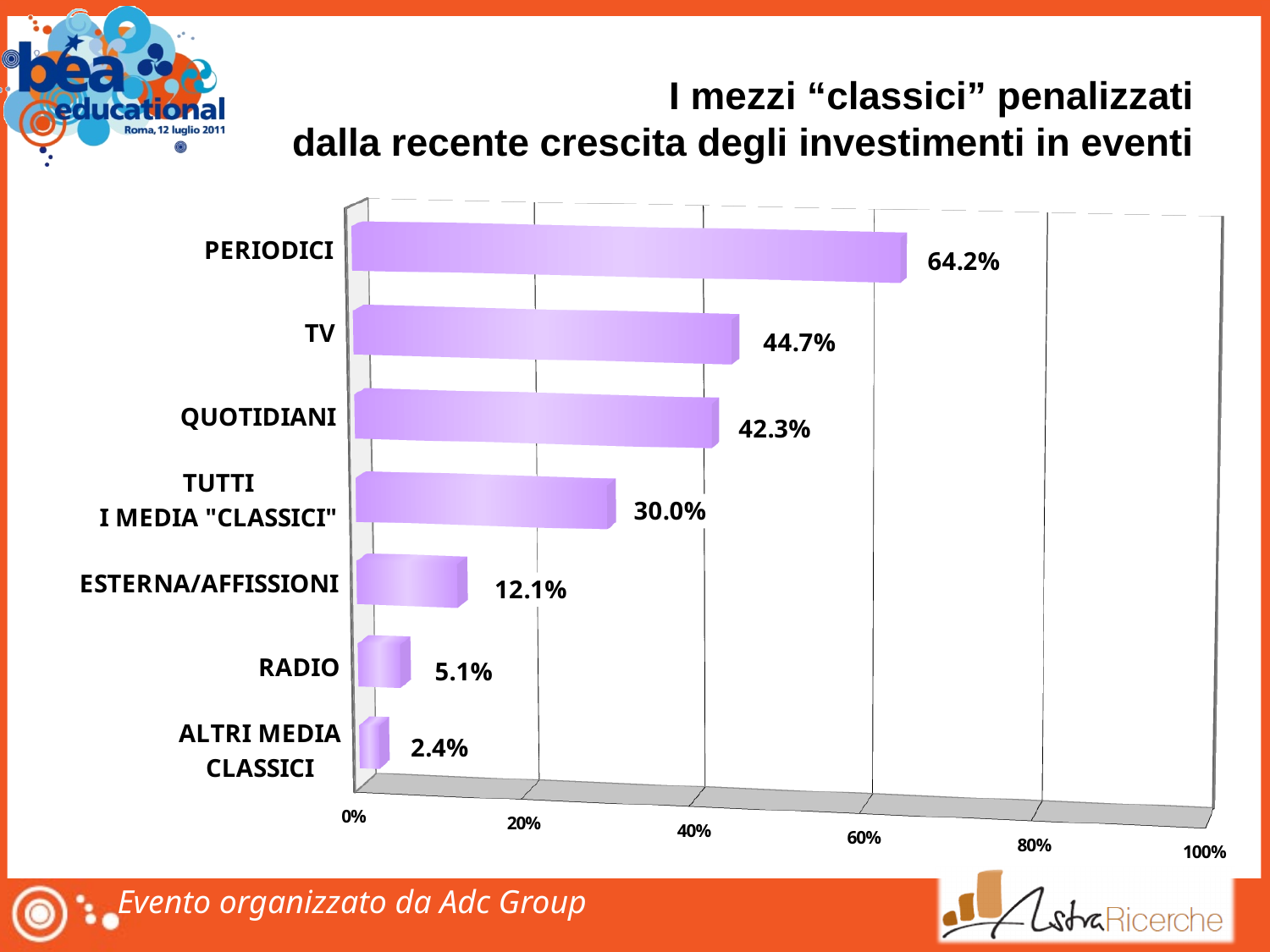
What is the value for TV? 44.7% What is the value for ALTRI MEDIA CLASSICI? 2.4% Is the value for TUTTI I MEDIA "CLASSICI" greater or less than 40%? less What is the value for PERIODICI? 64.2% What is the value for ESTERNA/AFFISSIONI? 12.1% Which category has the highest value? PERIODICI Which category has the lowest value? ALTRI MEDIA CLASSICI What is the difference between the values for RADIO and ALTRI MEDIA CLASSICI? 2.7% Which is larger, the value for TV or the value for QUOTIDIANI? TV What kind of chart is shown on the slide? bar chart How many categories are shown in the chart? 7 What is the difference between the values for PERIODICI and TV? 19.5%